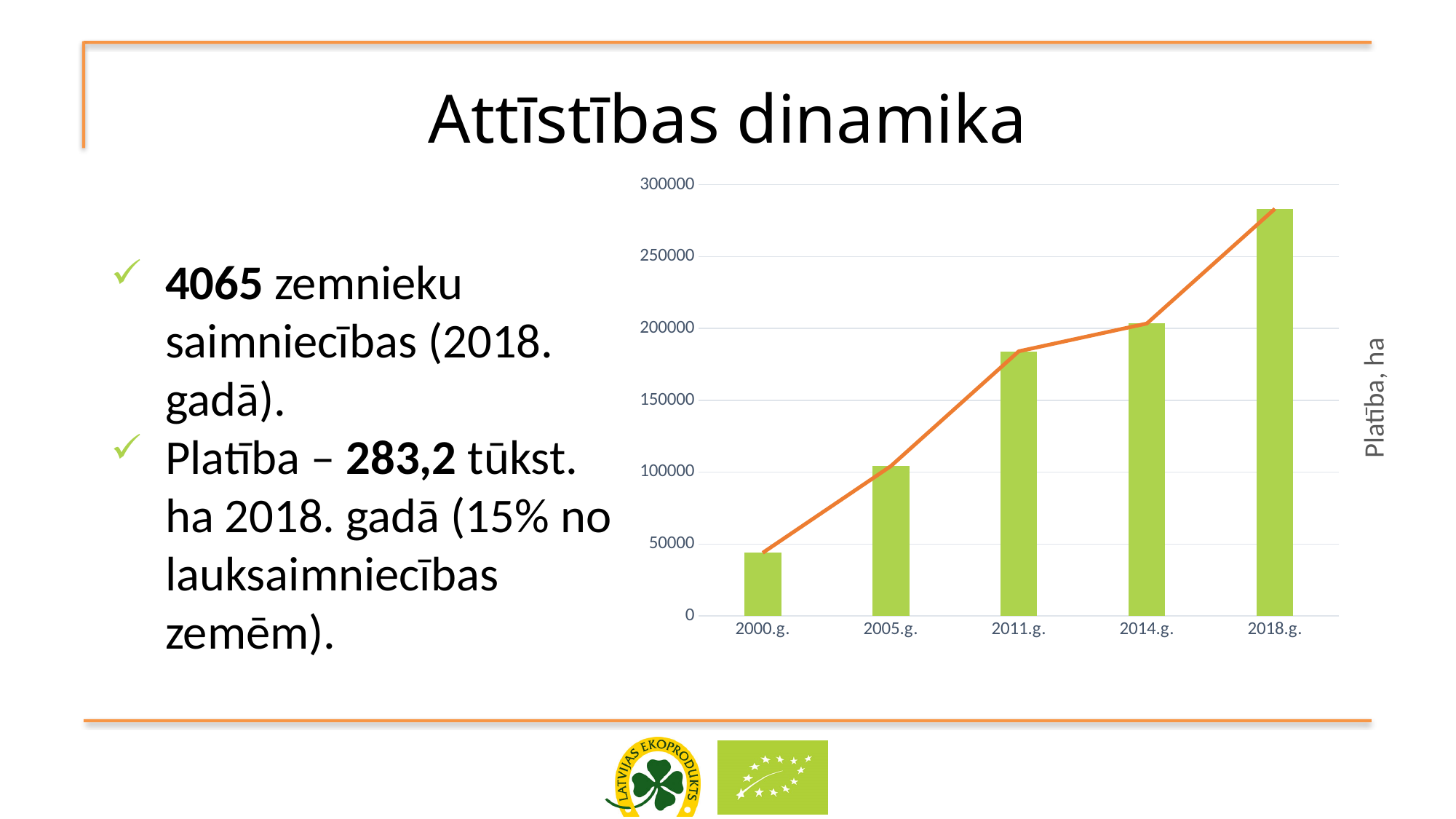
Which year has the lowest value in the chart? 2000.g. What colour are the bars in the chart? green Is the value for 2018.g. greater or less than 250000? greater What is the title of the vertical axis of the chart? Platība, ha Is the value for 2011.g. greater or less than 150000? greater What kind of chart is shown on the slide? combination bar and line chart Do the values rise or fall from 2000.g. to 2018.g.? rise Which is larger, the value for 2005.g. or the value for 2011.g.? 2011.g. Which year has the highest value in the chart? 2018.g. Is the value for 2005.g. greater or less than 150000? less How many years are shown on the x axis of the chart? 5